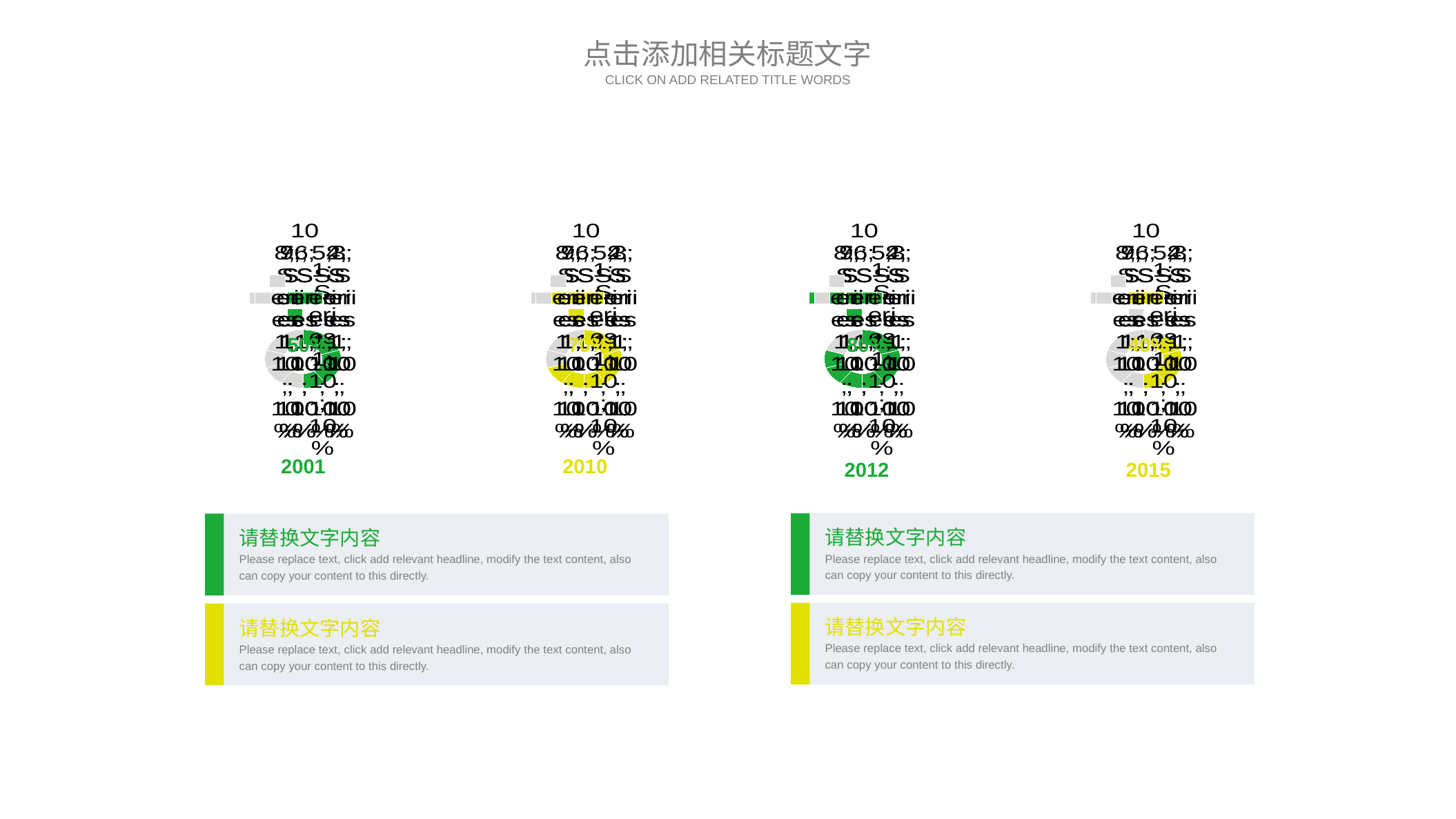
Which year label appears under the leftmost doughnut chart? 2001 In the doughnut chart labelled 2001, what percentage is printed in the centre? 50% Which year label appears under the rightmost doughnut chart? 2015 What kind of chart is shown above the year label 2001? doughnut chart How many doughnut charts are shown on the slide? 4